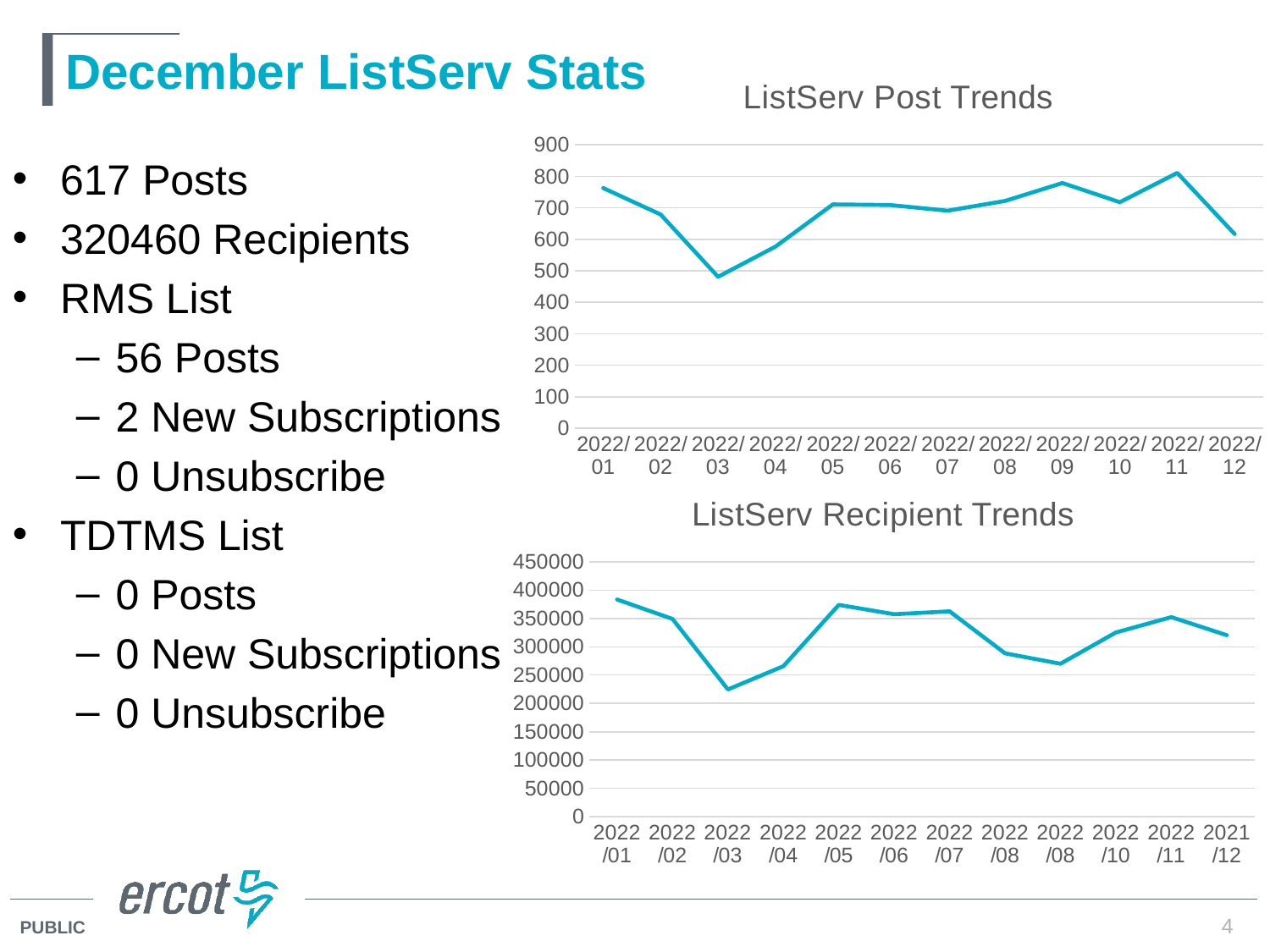
What is the title of the lower chart on the slide? ListServ Recipient Trends In the ListServ Recipient Trends chart, which month has the lowest number of recipients? 2022/03 In the ListServ Recipient Trends chart, is the value for 2022/03 greater or less than 250000? less In the ListServ Post Trends chart, which is larger, the value for 2022/03 or the value for 2022/05? 2022/05 How many data points are plotted in the ListServ Post Trends chart? 12 In the ListServ Post Trends chart, which month has the highest number of posts? 2022/11 In the ListServ Post Trends chart, do the values rise or fall from 2022/11 to 2022/12? fall In the ListServ Post Trends chart, which month has the lowest number of posts? 2022/03 In the ListServ Post Trends chart, is the value for 2022/03 greater or less than 500? less What kind of chart is the ListServ Post Trends chart? line chart In the ListServ Recipient Trends chart, is the value for 2022/05 greater or less than 350000? greater